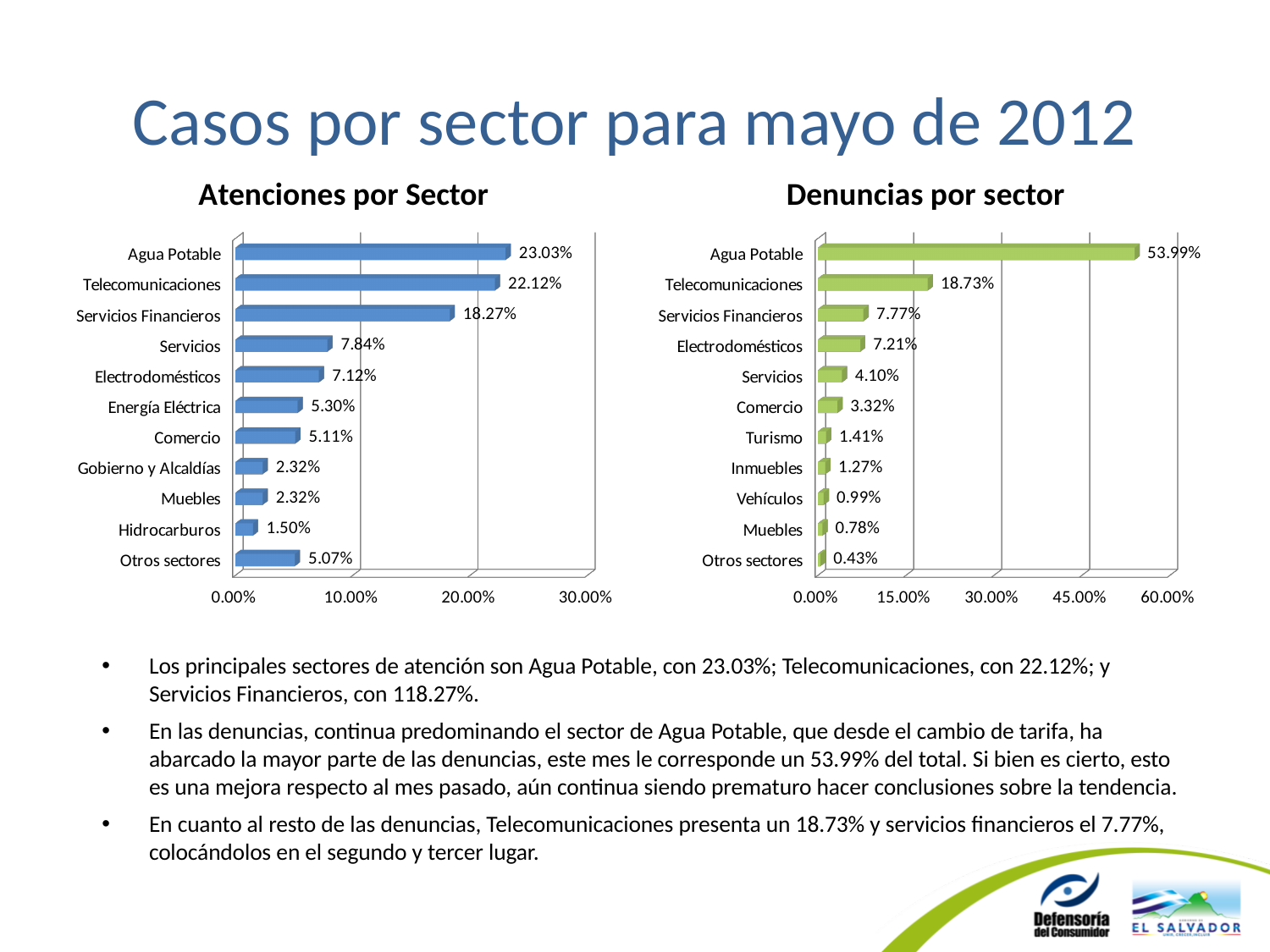
In the 'Denuncias por sector' chart, is the value for Agua Potable greater or less than 45.00%? greater In the 'Denuncias por sector' chart, what is the value for Telecomunicaciones? 18.73% How many sectors are shown in the 'Denuncias por sector' chart? 11 What is the title of the chart on the right side of the slide? Denuncias por sector What kind of chart is 'Atenciones por Sector'? Bar chart In the 'Atenciones por Sector' chart, what is the value for Otros sectores? 5.07% In the 'Atenciones por Sector' chart, what is the value for Servicios Financieros? 18.27% In the 'Atenciones por Sector' chart, which is larger: Servicios or Electrodomésticos? Servicios In the 'Atenciones por Sector' chart, which sector has the highest value? Agua Potable In the 'Denuncias por sector' chart, which sector has the lowest value? Otros sectores In the 'Denuncias por sector' chart, what is the difference between Agua Potable and Telecomunicaciones? 35.26% In the 'Atenciones por Sector' chart, which sector has the lowest value? Hidrocarburos